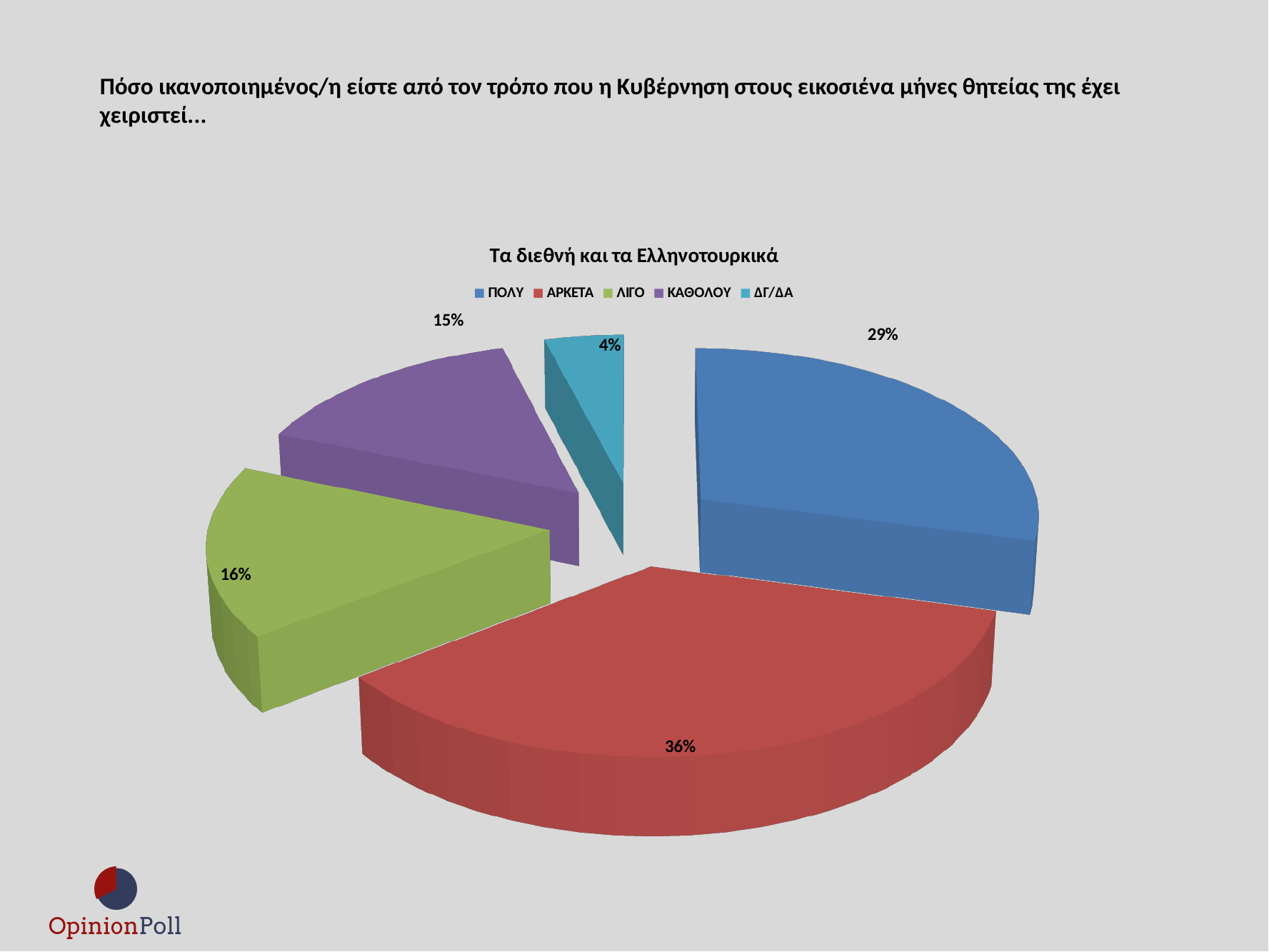
Which category has the largest share of the pie? ΑΡΚΕΤΑ Which category has the smallest share of the pie? ΔΓ/ΔΑ What percentage is shown for ΔΓ/ΔΑ? 4% Which colour represents ΚΑΘΟΛΟΥ in the chart? purple What percentage is shown for ΚΑΘΟΛΟΥ? 15% What percentage is shown for ΑΡΚΕΤΑ? 36% What percentage is shown for ΛΙΓΟ? 16% What is the chart's title? Τα διεθνή και τα Ελληνοτουρκικά How many categories does the legend list? 5 What percentage is shown for ΠΟΛΥ? 29% What is the difference in percentage points between ΑΡΚΕΤΑ and ΠΟΛΥ? 7 What type of chart is shown on the slide? pie chart